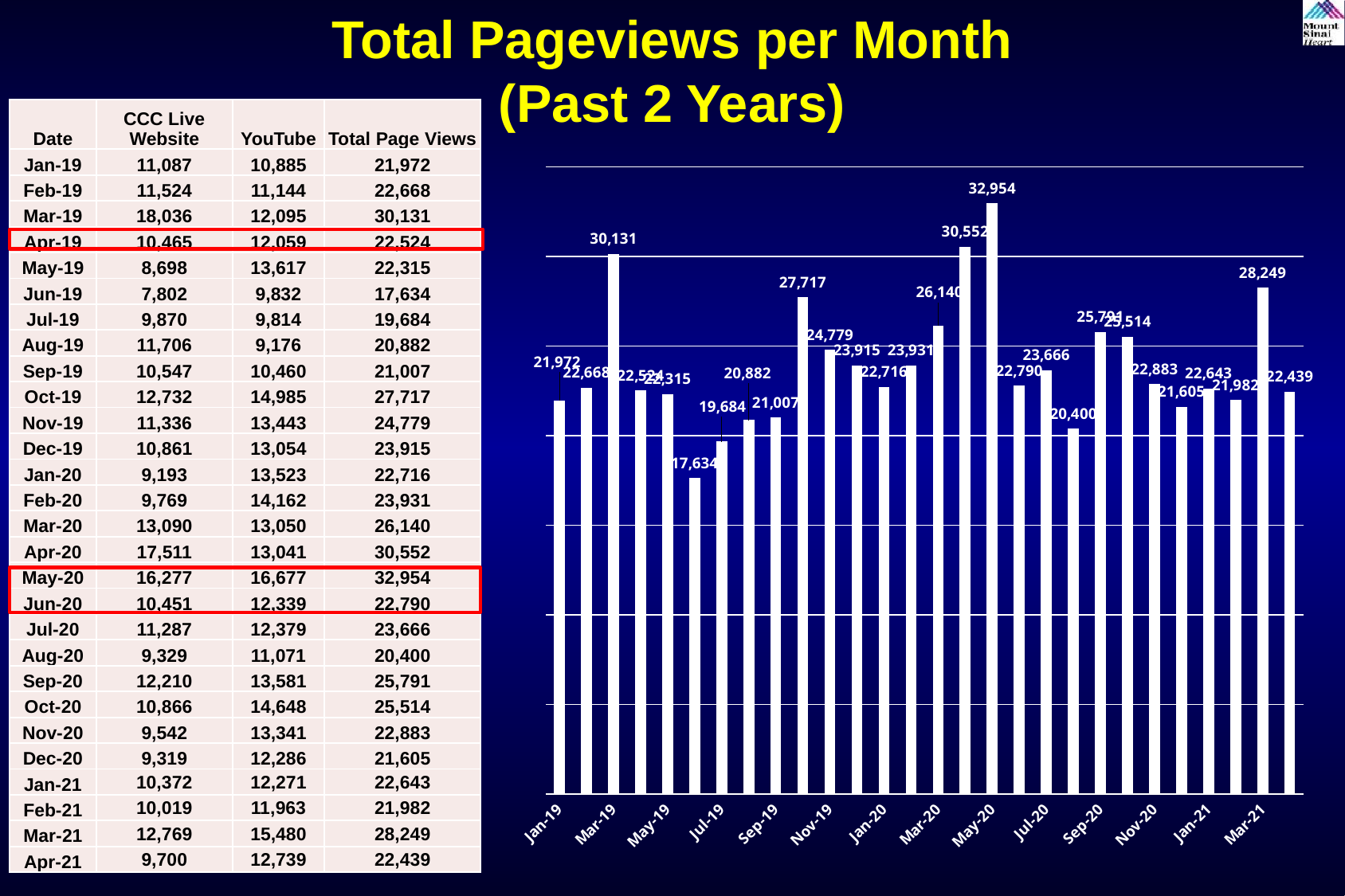
Which month has the larger value, Oct-19 or Mar-20? Oct-19 How much higher is the Mar-19 value than the Mar-21 value? 1,882 Which month has the lowest total pageviews on the chart? Jun-19 What kind of chart is used to show the monthly pageviews? Bar chart What is the value labelled on the bar for Aug-20? 20,400 What value is shown for Mar-21 on the chart? 28,249 How many monthly bars are plotted on the chart? 28 Do the values rise or fall from Mar-19 to Jun-19? Fall What is the difference between the highest bar (May-20) and the lowest bar (Jun-19)? 15,320 What value does the chart show for Apr-20? 30,552 Which month has the highest total pageviews on the chart? May-20 What is the total pageviews value shown for May-20 on the chart? 32,954